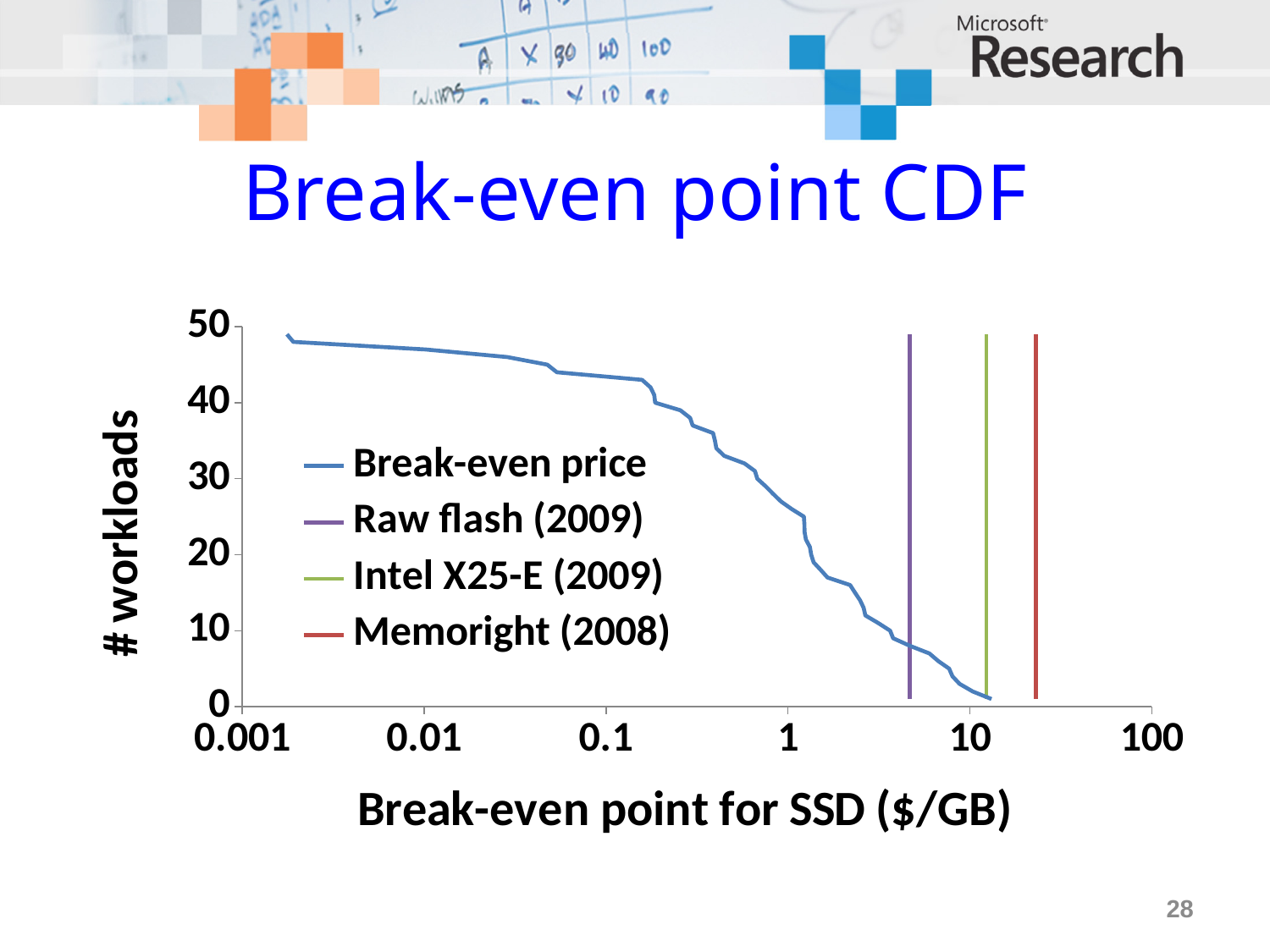
Which of the three vertical price lines is at the highest $/GB value? Memoright (2008) Is the number of workloads on the Break-even price curve at 10 $/GB greater or less than 10? less How many series does the legend list? 4 Is the Memoright (2008) price line positioned at a value greater or less than 10 $/GB? greater What is the title of the chart? Break-even point CDF Which is at a higher $/GB value, the Raw flash (2009) line or the Intel X25-E (2009) line? Intel X25-E (2009) Is the number of workloads on the Break-even price curve at 1 $/GB greater or less than 20? greater What is the label of the x axis? Break-even point for SSD ($/GB) Does the Break-even price curve rise or fall as the break-even point increases along the x axis? fall What kind of chart is shown on the slide? line chart